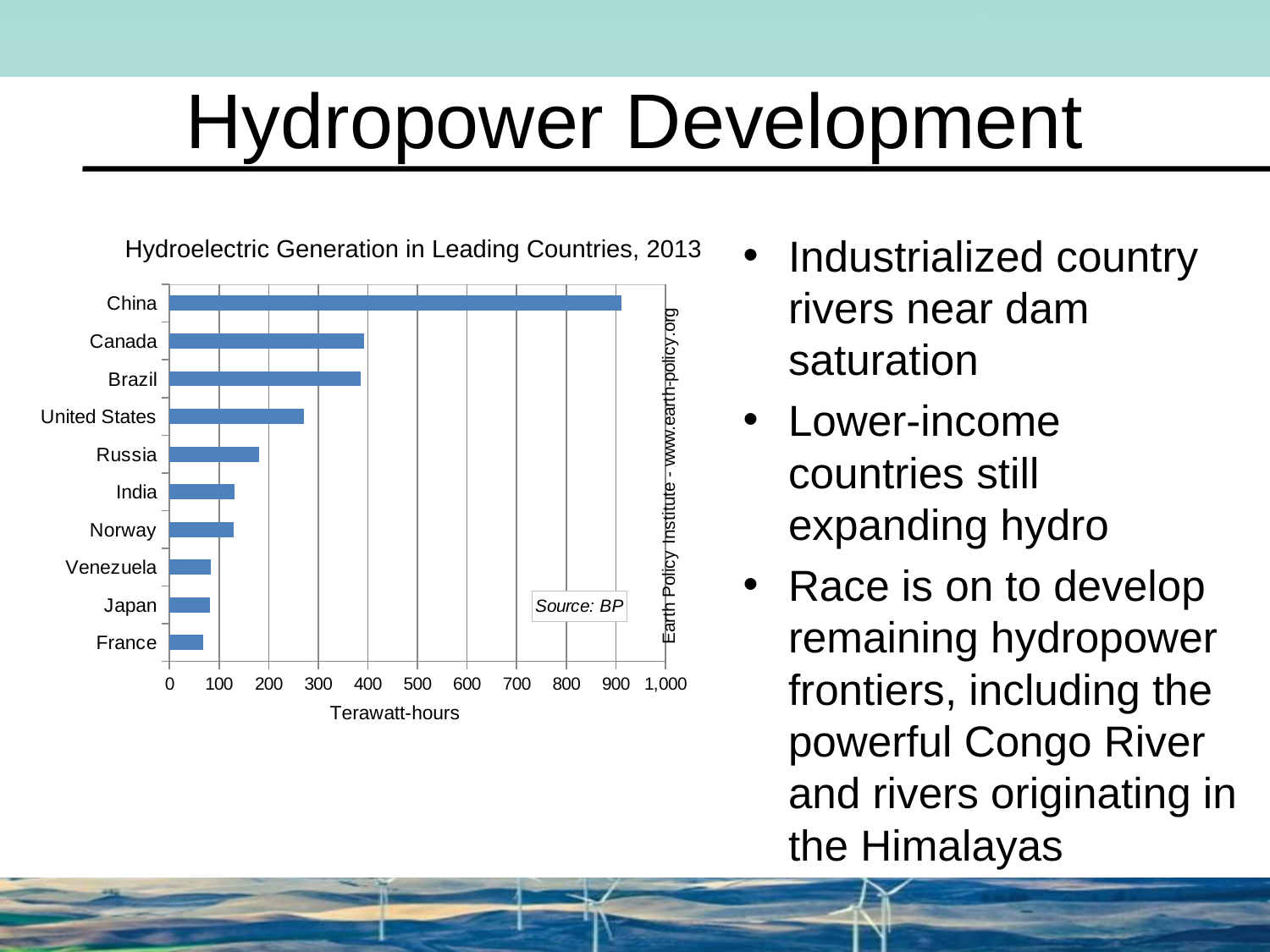
Is the value for Canada greater or less than 300 terawatt-hours? greater Is the value for Russia greater or less than 200 terawatt-hours? less Which has a larger value, China or Canada? China Is the value for China greater or less than 800 terawatt-hours? greater What unit is shown on the x axis of the chart? Terawatt-hours Which country has the highest hydroelectric generation in the chart? China What is the title of the chart? Hydroelectric Generation in Leading Countries, 2013 Which has a larger value, the United States or Russia? United States What kind of chart is shown on the slide? bar chart How many countries are shown in the chart? 10